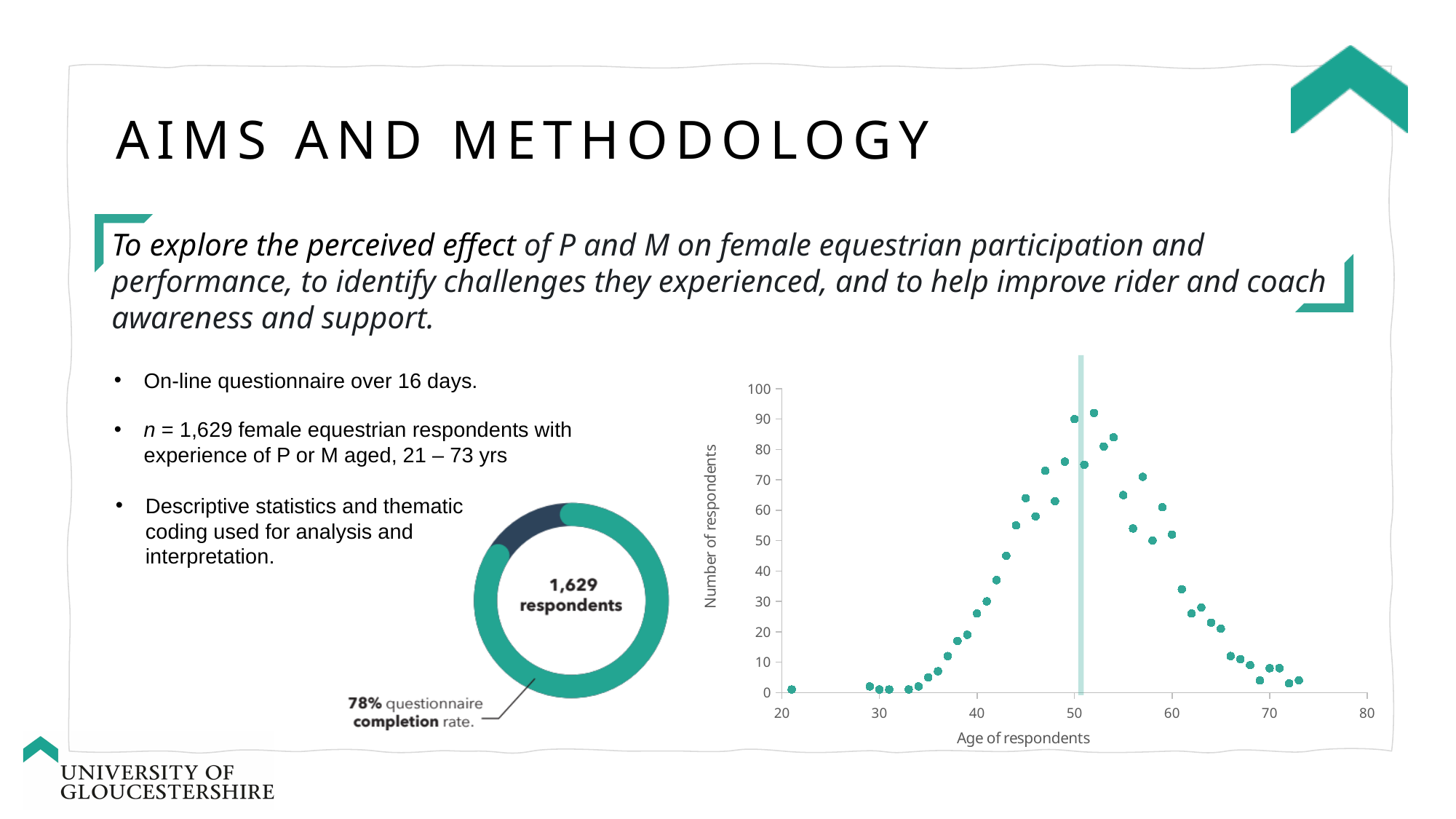
On the scatter chart, is the number of respondents at age 30 greater or less than 10? less On the scatter chart, is the highest plotted value greater or less than 80? greater On the donut chart, how many respondents are shown in the centre? 1,629 respondents On the scatter chart, do the values rise or fall as age increases from 30 to 50? rise On the donut chart, what questionnaire completion rate is shown? 78% On the scatter chart, is the number of respondents at age 60 greater or less than 40? greater On the scatter chart, do the values rise or fall as age increases from 55 to 73? fall On the scatter chart, what is the title of the y axis? Number of respondents What kind of chart is the chart on the right of the slide? scatter chart On the scatter chart, what is the title of the x axis? Age of respondents